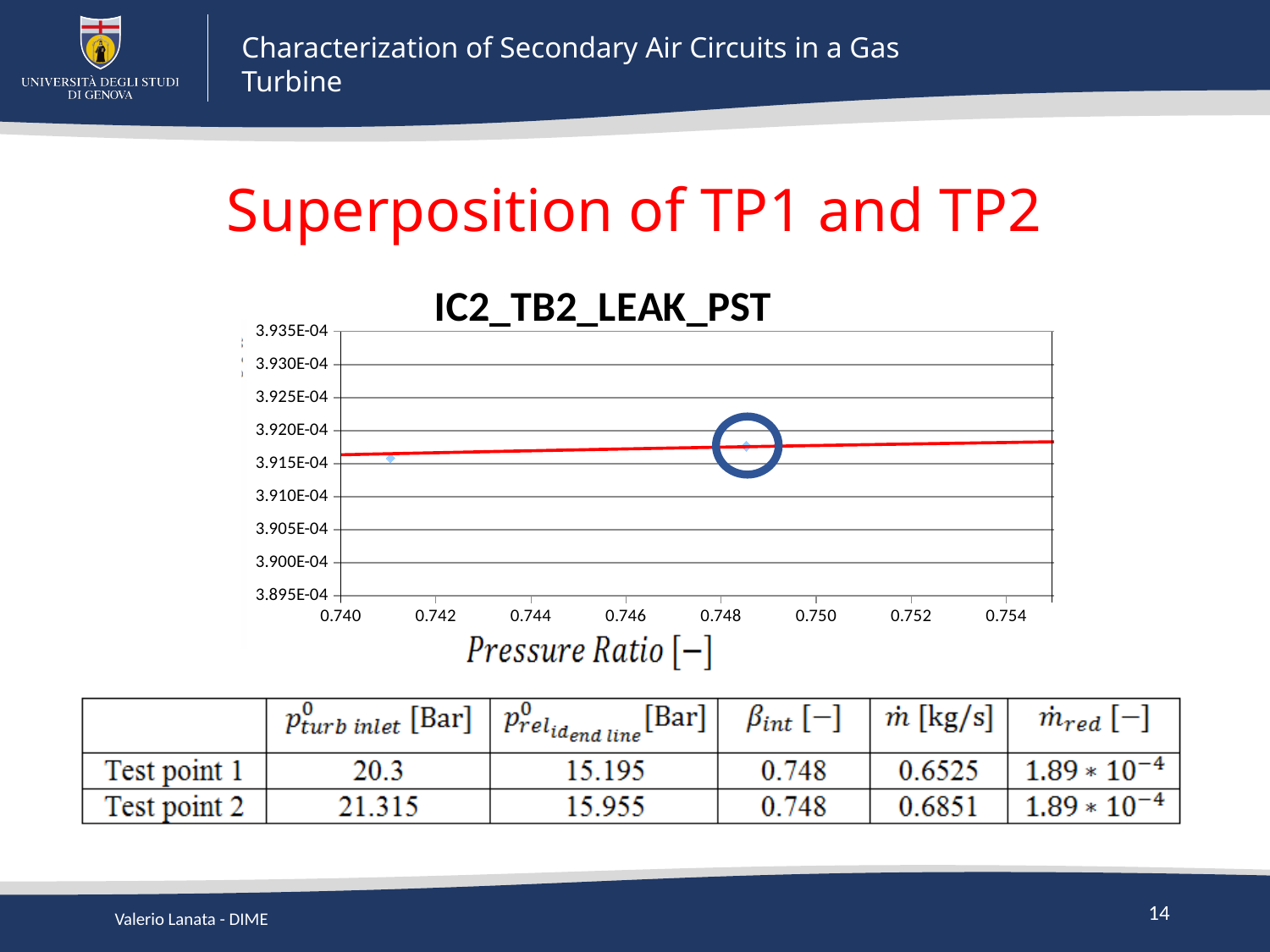
How many data points are plotted on the chart? 2 Is the value of the circled data point greater or less than 3.910E-04? greater What kind of chart is shown on the slide? scatter chart What is the title of the chart? IC2_TB2_LEAK_PST Is the value of the circled data point greater or less than 3.925E-04? less Is the pressure ratio of the circled data point greater or less than 0.746? greater Does the red trend line rise or fall as the pressure ratio increases along the x axis? rises What is the label of the x axis of the chart? Pressure Ratio [-]